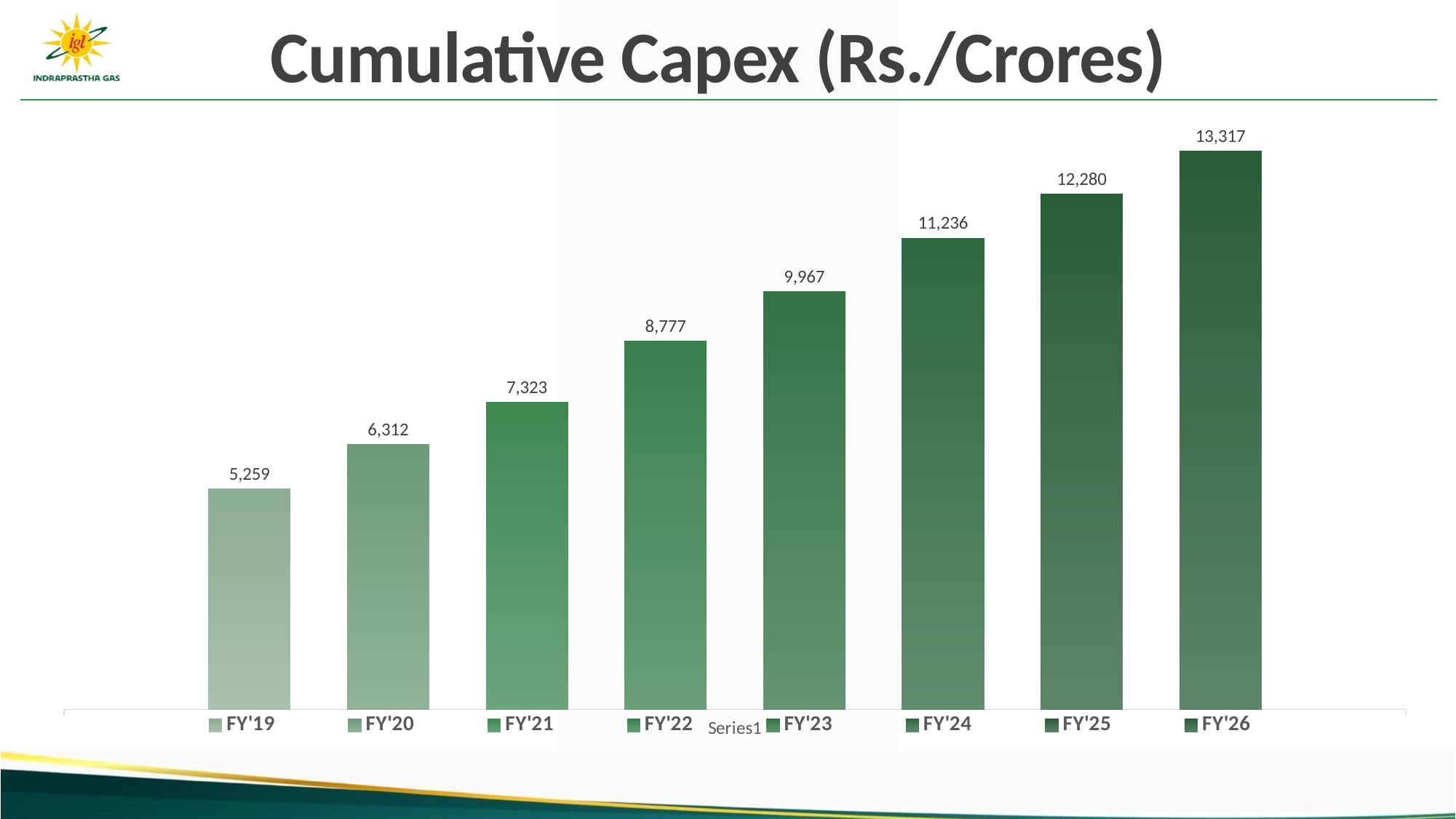
How many fiscal years are shown in the chart? 8 Which fiscal year has the lowest cumulative capex? FY'19 Which fiscal year has the highest cumulative capex? FY'26 What is the difference between the cumulative capex for FY'21 and FY'20? 1,011 What is the difference between the cumulative capex for FY'26 and FY'25? 1,037 What kind of chart is shown on the slide? Bar chart What is the cumulative capex value for FY'22? 8,777 What is the cumulative capex value for FY'19? 5,259 What is the cumulative capex value for FY'24? 11,236 Do the cumulative capex values rise or fall from FY'19 to FY'26? Rise Which is larger, the cumulative capex for FY'23 or FY'22? FY'23 What is the title of the chart? Cumulative Capex (Rs./Crores)